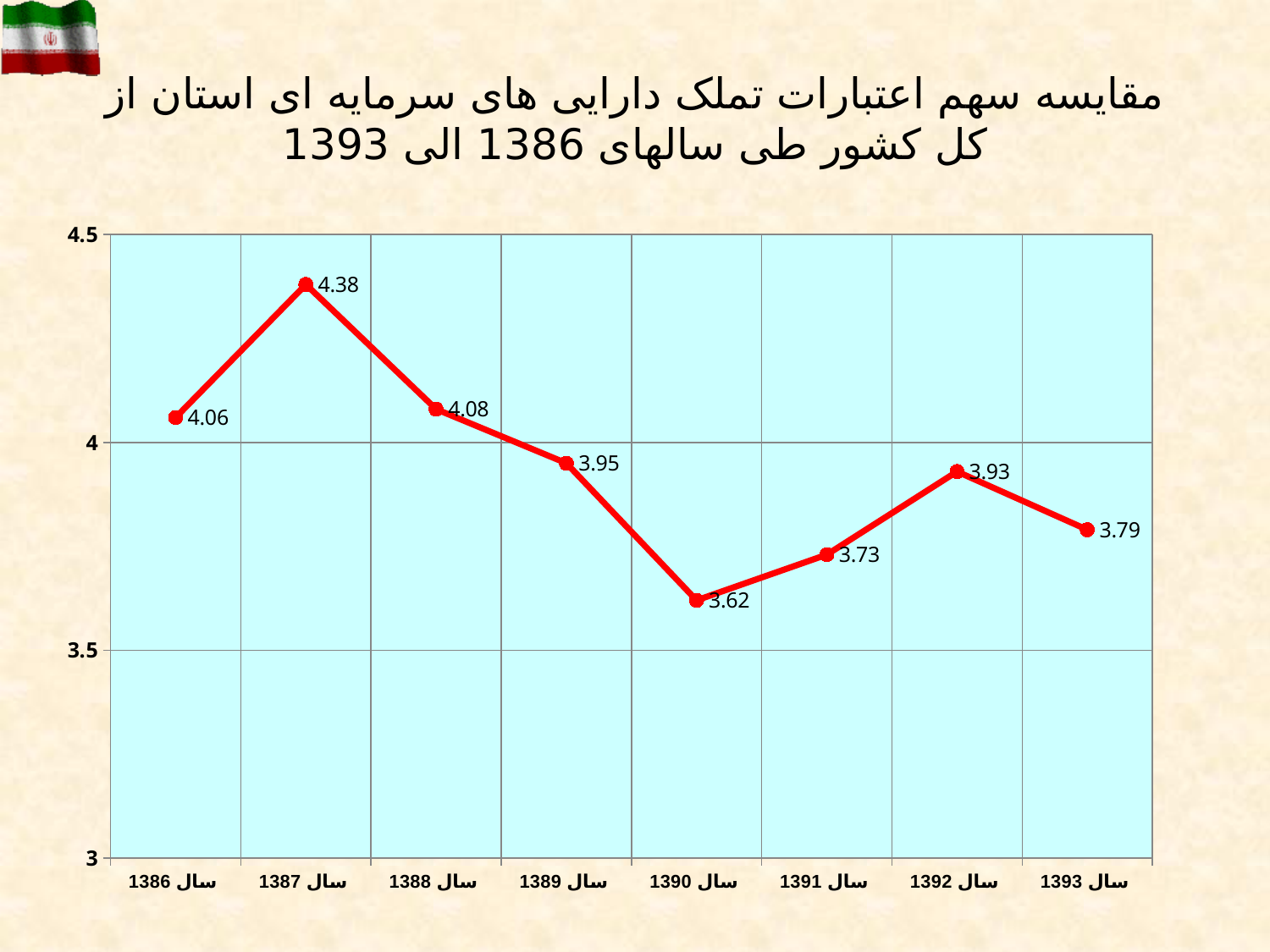
What is the value for سال 1393? 3.79 Does the value rise or fall from سال 1388 to سال 1390? fall Which year has the highest value? سال 1387 What is the difference between the values for سال 1387 and سال 1390? 0.76 What type of chart is shown on the slide? line chart What is the value for سال 1390? 3.62 What colour is the plotted line? red What is the value for سال 1387? 4.38 Which year has the lowest value? سال 1390 Is the value for سال 1391 greater or less than 4? less Which is larger, the value for سال 1386 or the value for سال 1388? سال 1388 How many data points are plotted on the chart? 8